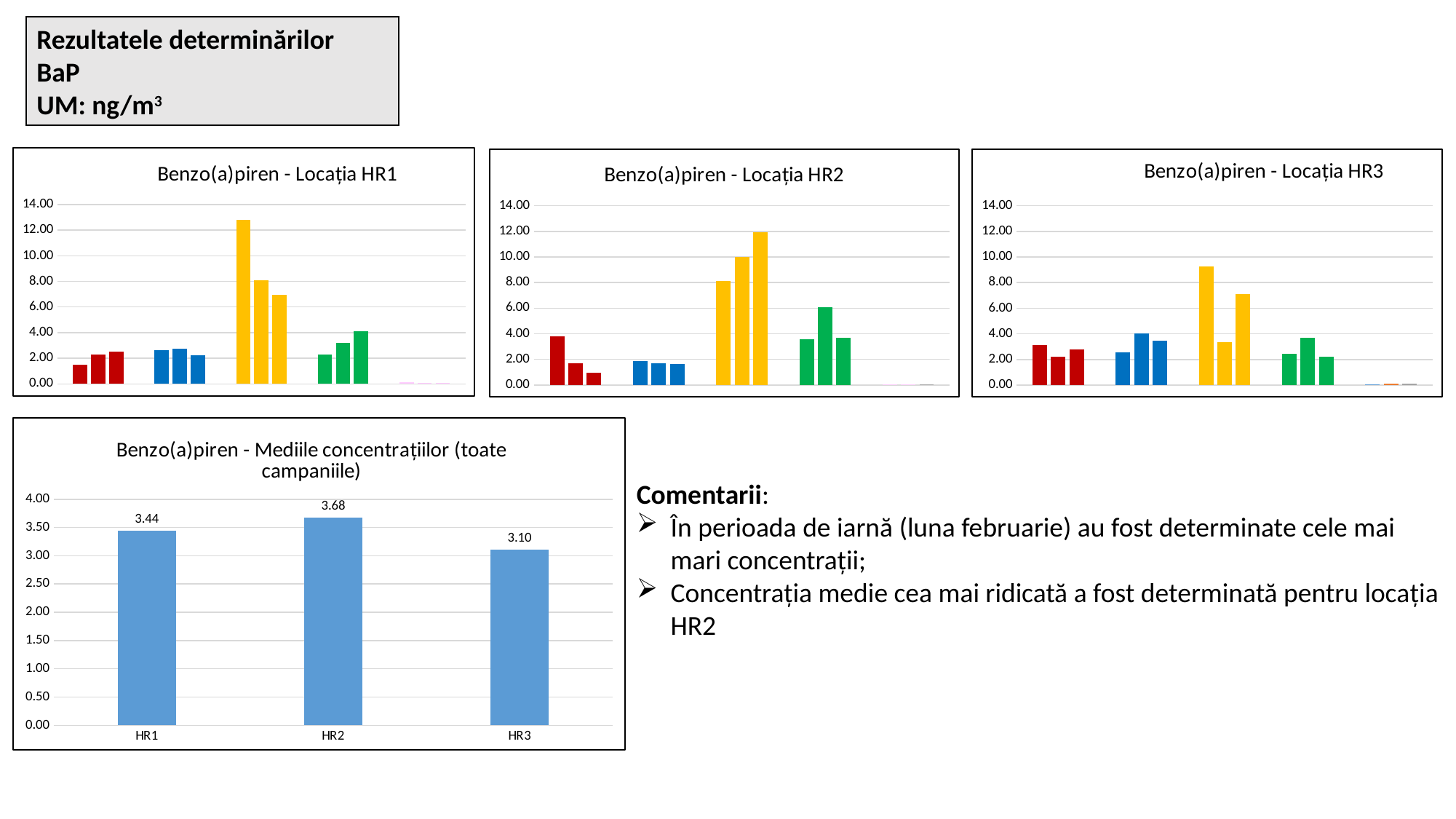
How many locations are shown in the chart 'Benzo(a)piren - Mediile concentrațiilor (toate campaniile)'? 3 In the chart 'Benzo(a)piren - Mediile concentrațiilor (toate campaniile)', which location has the highest average concentration? HR2 In the chart 'Benzo(a)piren - Mediile concentrațiilor (toate campaniile)', which location has the lowest average concentration? HR3 In the chart 'Benzo(a)piren - Locația HR3', is the tallest bar greater or less than 10.00? less In the chart 'Benzo(a)piren - Mediile concentrațiilor (toate campaniile)', which is larger, the value for HR1 or the value for HR3? HR1 How many charts are shown on the slide? 4 In the chart 'Benzo(a)piren - Mediile concentrațiilor (toate campaniile)', what is the value for HR1? 3.44 In the chart 'Benzo(a)piren - Mediile concentrațiilor (toate campaniile)', what is the value for HR3? 3.10 In the chart 'Benzo(a)piren - Mediile concentrațiilor (toate campaniile)', what is the value for HR2? 3.68 In the chart 'Benzo(a)piren - Mediile concentrațiilor (toate campaniile)', what is the difference between the values for HR2 and HR3? 0.58 In the chart 'Benzo(a)piren - Locația HR1', is the tallest bar greater or less than 12.00? greater What kind of chart is 'Benzo(a)piren - Mediile concentrațiilor (toate campaniile)'? bar chart